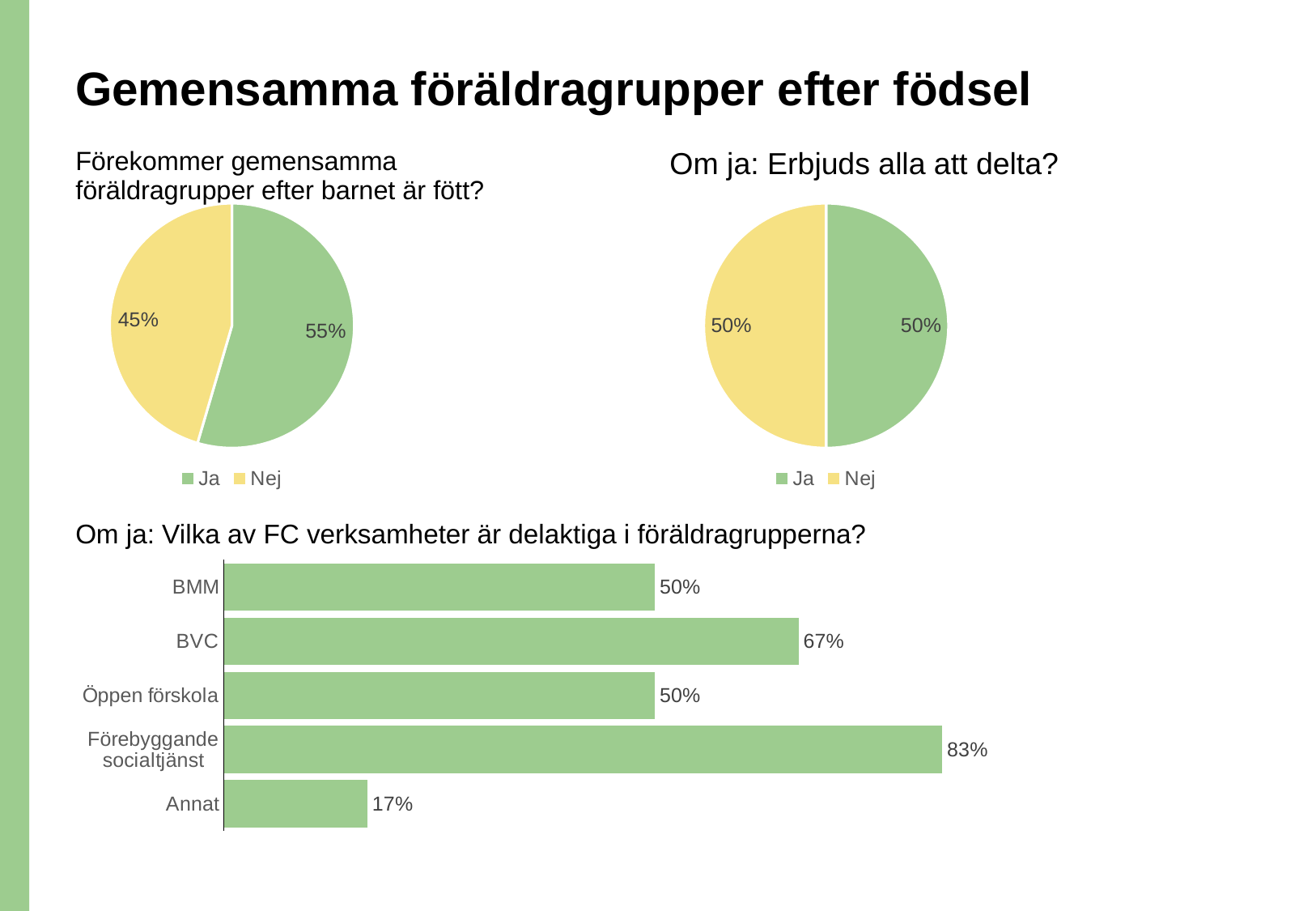
In the bottom bar chart, which category has the lowest value? Annat What kind of chart is the bottom chart (Om ja: Vilka av FC verksamheter är delaktiga i föräldragrupperna?)? bar chart How many categories are shown in the bottom bar chart? 5 In the bottom bar chart, what is the value for Annat? 17% In the top-left pie chart (Förekommer gemensamma föräldragrupper efter barnet är fött?), what share is Ja? 55% In the top-right pie chart (Om ja: Erbjuds alla att delta?), how many entries does the legend list? 2 In the bottom bar chart, which category has the highest value? Förebyggande socialtjänst In the top-right pie chart (Om ja: Erbjuds alla att delta?), what share is Ja? 50% In the bottom bar chart, what is the difference between Förebyggande socialtjänst and BMM? 33% In the top-left pie chart (Förekommer gemensamma föräldragrupper efter barnet är fött?), which slice is larger, Ja or Nej? Ja In the top-left pie chart (Förekommer gemensamma föräldragrupper efter barnet är fött?), what share is Nej? 45% In the bottom bar chart, what is the value for BVC? 67%